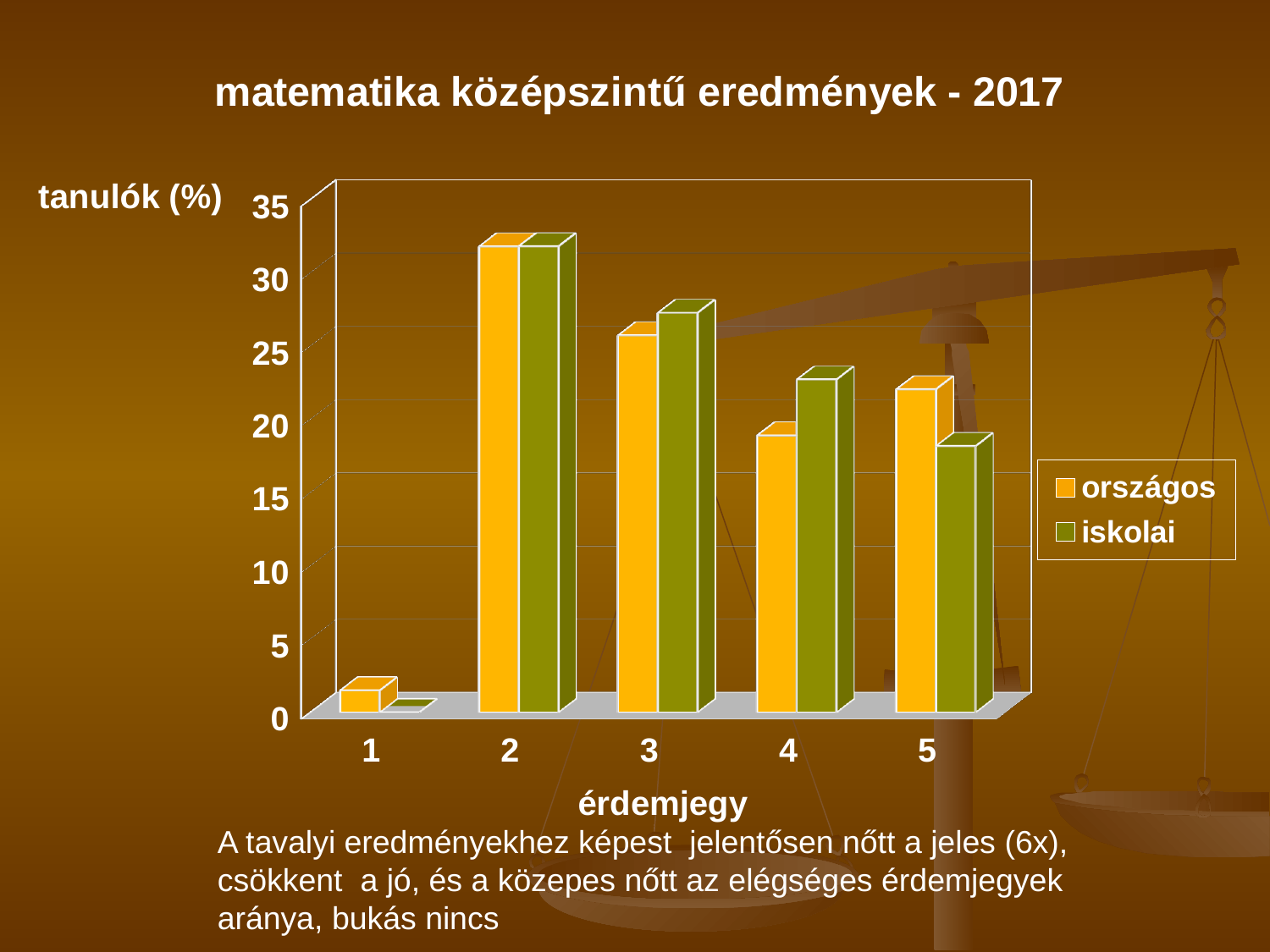
For érdemjegy 5, which series has the larger value, országos or iskolai? országos For érdemjegy 4, which series has the larger value, országos or iskolai? iskolai Is the iskolai value for érdemjegy 4 greater or less than 20? greater Which érdemjegy has the lowest value for the országos series? 1 Is the iskolai value for érdemjegy 5 greater or less than 20? less Which érdemjegy has the highest value for the országos series? 2 How many series does the legend list? 2 Is the országos value for érdemjegy 2 greater or less than 30? greater Which érdemjegy has the lowest value for the iskolai series? 1 What is the title of the chart? matematika középszintű eredmények - 2017 What kind of chart is shown on the slide? bar chart How many érdemjegy categories are shown on the x axis? 5